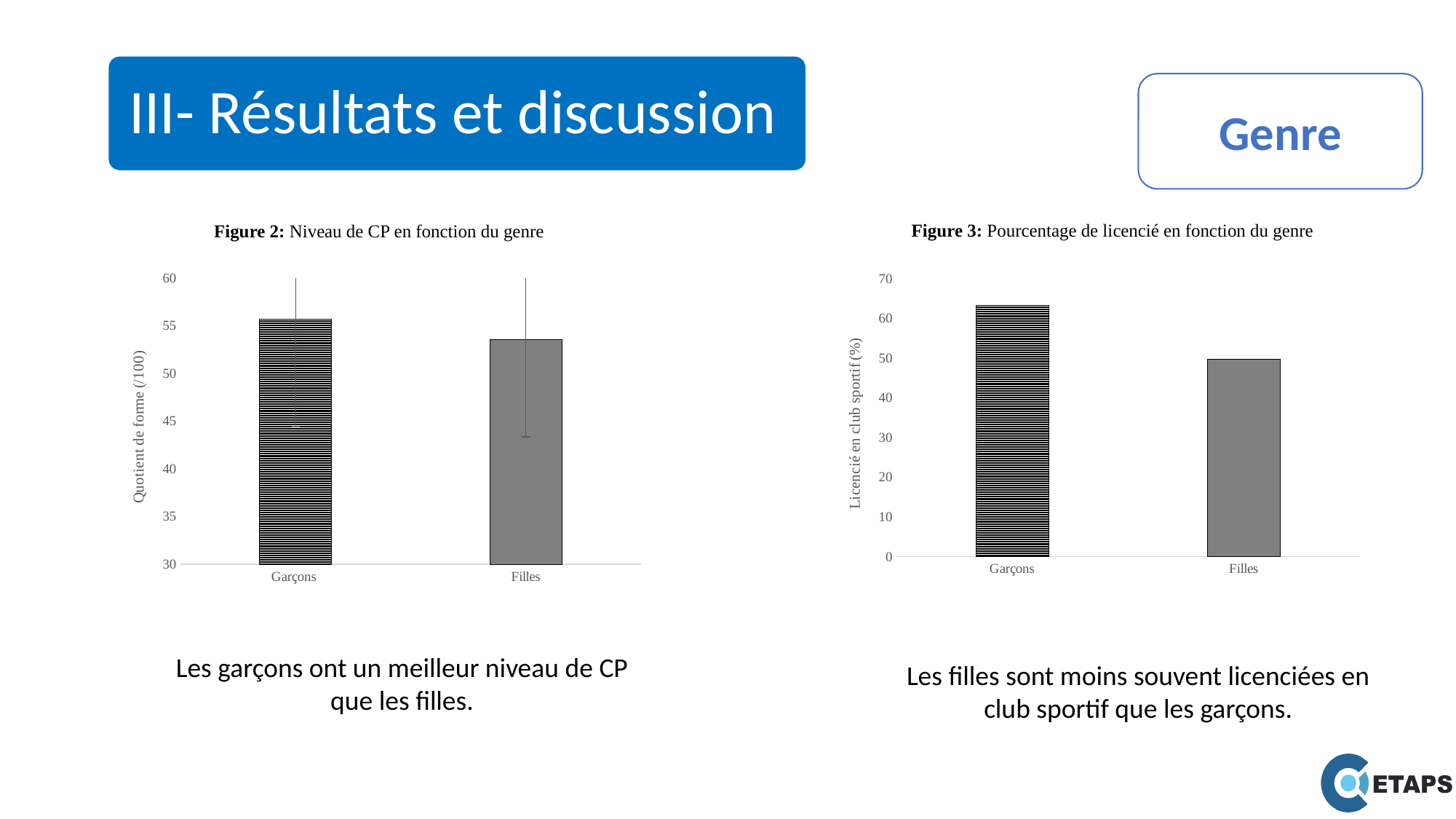
In Figure 2: Niveau de CP en fonction du genre, what is the label of the y axis? Quotient de forme (/100) What kind of chart is Figure 2: Niveau de CP en fonction du genre? bar chart In Figure 2: Niveau de CP en fonction du genre, is the value for Filles greater or less than 55? less In Figure 3: Pourcentage de licencié en fonction du genre, what is the label of the y axis? Licencié en club sportif (%) In Figure 2: Niveau de CP en fonction du genre, which category has the highest value? Garçons In Figure 3: Pourcentage de licencié en fonction du genre, is the value for Garçons larger or smaller than the value for Filles? larger In Figure 2: Niveau de CP en fonction du genre, how many categories are shown on the x axis? 2 What kind of chart is Figure 3: Pourcentage de licencié en fonction du genre? bar chart In Figure 2: Niveau de CP en fonction du genre, which category has the lowest value? Filles In Figure 3: Pourcentage de licencié en fonction du genre, is the value for Garçons greater or less than 60? greater In Figure 2: Niveau de CP en fonction du genre, is the value for Garçons greater or less than 55? greater In Figure 3: Pourcentage de licencié en fonction du genre, which category has the highest value? Garçons